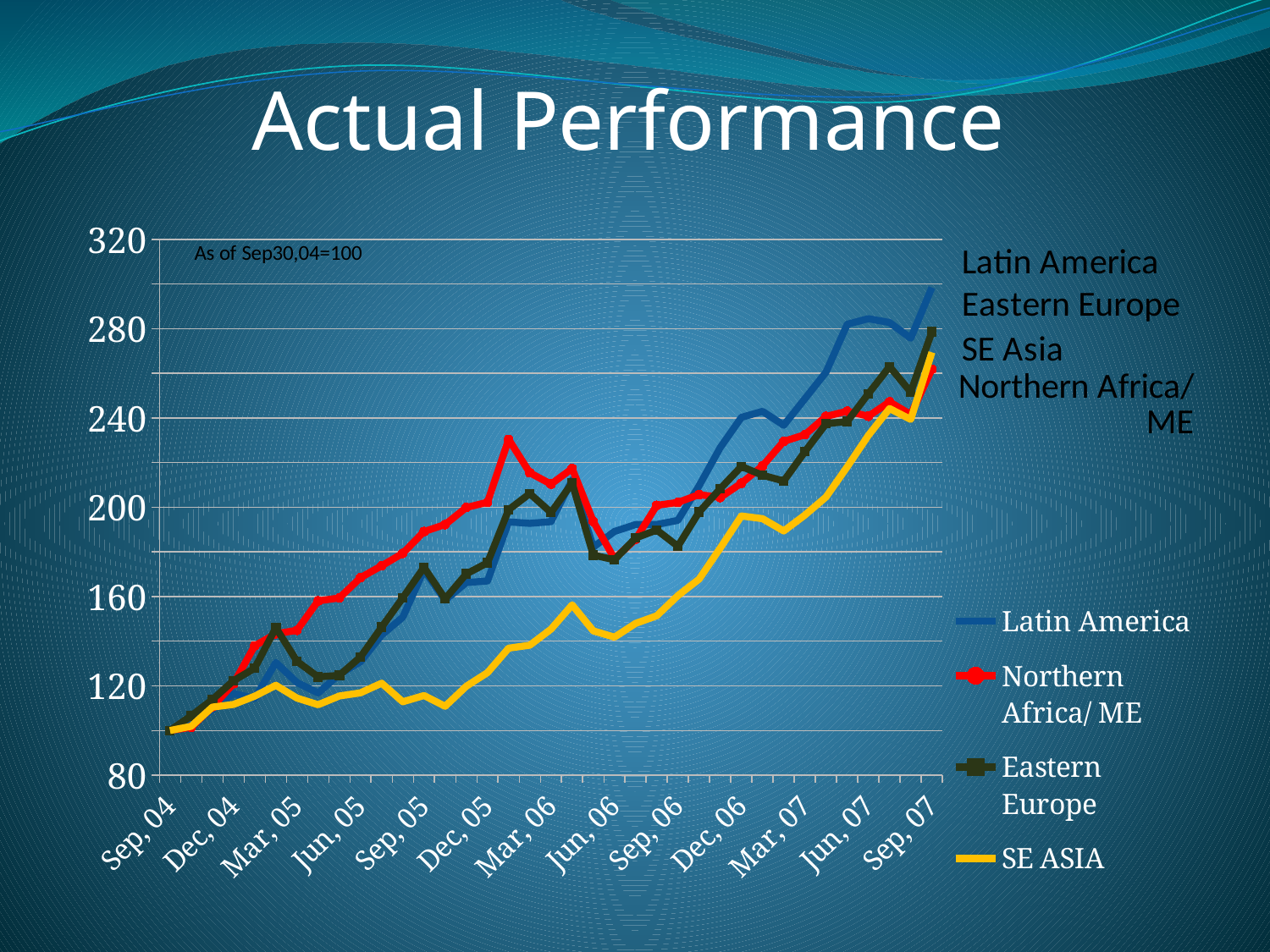
Is the value for Northern Africa/ME at Mar, 06 greater or less than 200? greater Is the value for SE ASIA at Sep, 05 greater or less than 120? less At Mar, 06, which is higher: Northern Africa/ME or SE ASIA? Northern Africa/ME Which series has the highest value at Sep, 07? Latin America What is the title of the chart? Actual Performance What base value does the note on the chart say the index is set to as of Sep 30, 04? 100 Which series is the lowest for most of the period shown? SE ASIA Do the values generally rise or fall from Sep, 04 to Sep, 07? rise How many series does the legend list? 4 Is the value for Latin America at Sep, 07 greater or less than 280? greater How many labelled points are there along the x axis? 13 What kind of chart is shown on the slide? line chart